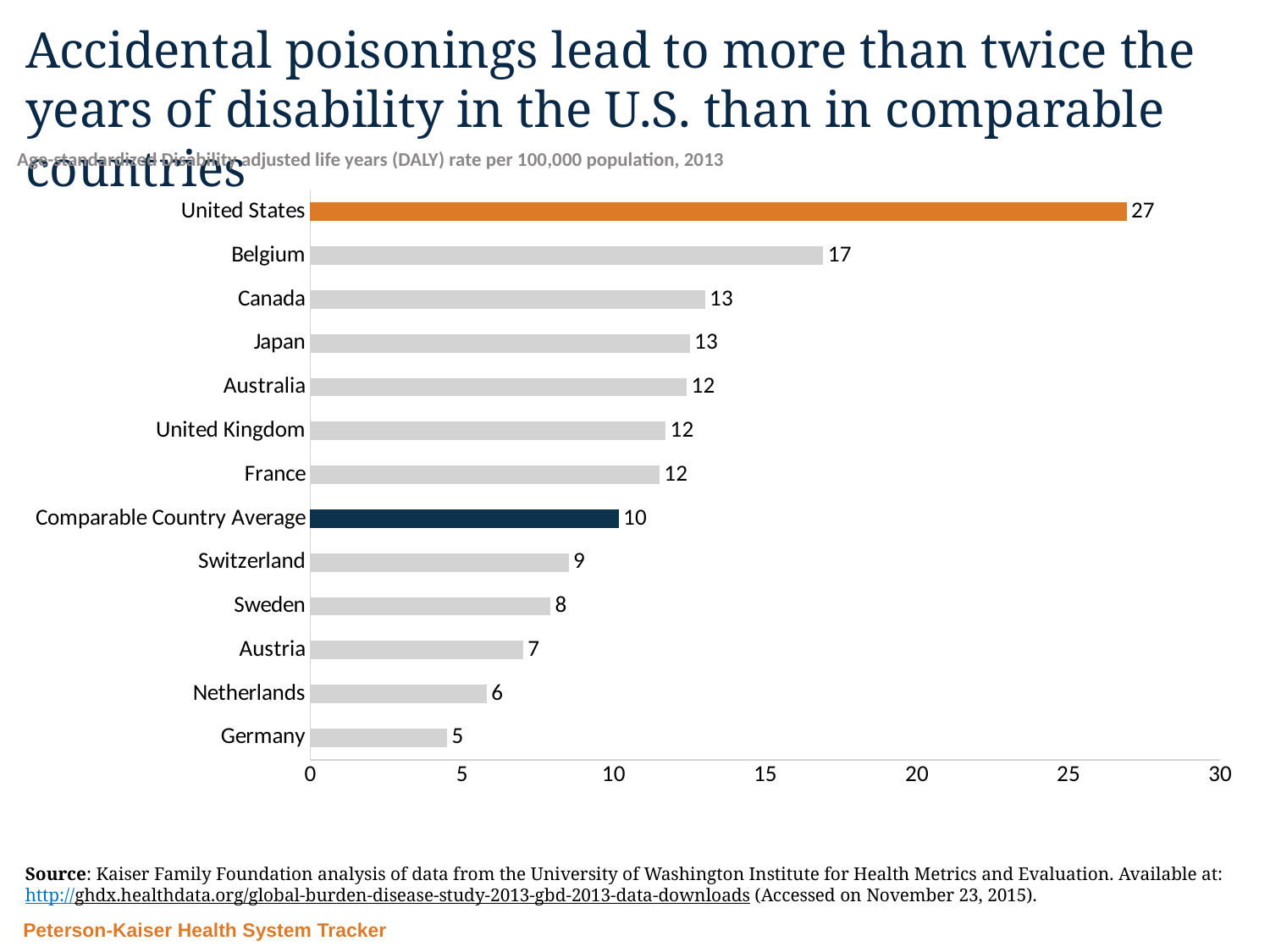
What is the value shown for the Comparable Country Average? 10 How many bars are shown on the chart? 13 What is the value shown for Belgium? 17 What is the DALY rate per 100,000 population for the United States? 27 Is the value for the United States greater or less than 25? greater Which has a higher value, Switzerland or Sweden? Switzerland Which country has the lowest DALY rate on the chart? Germany What type of chart is shown on the slide? Bar chart Which country has the highest DALY rate on the chart? United States Which bar is coloured orange? United States What is the difference between the United States value and the Comparable Country Average? 17 What is the difference between the values for Belgium and Canada? 4